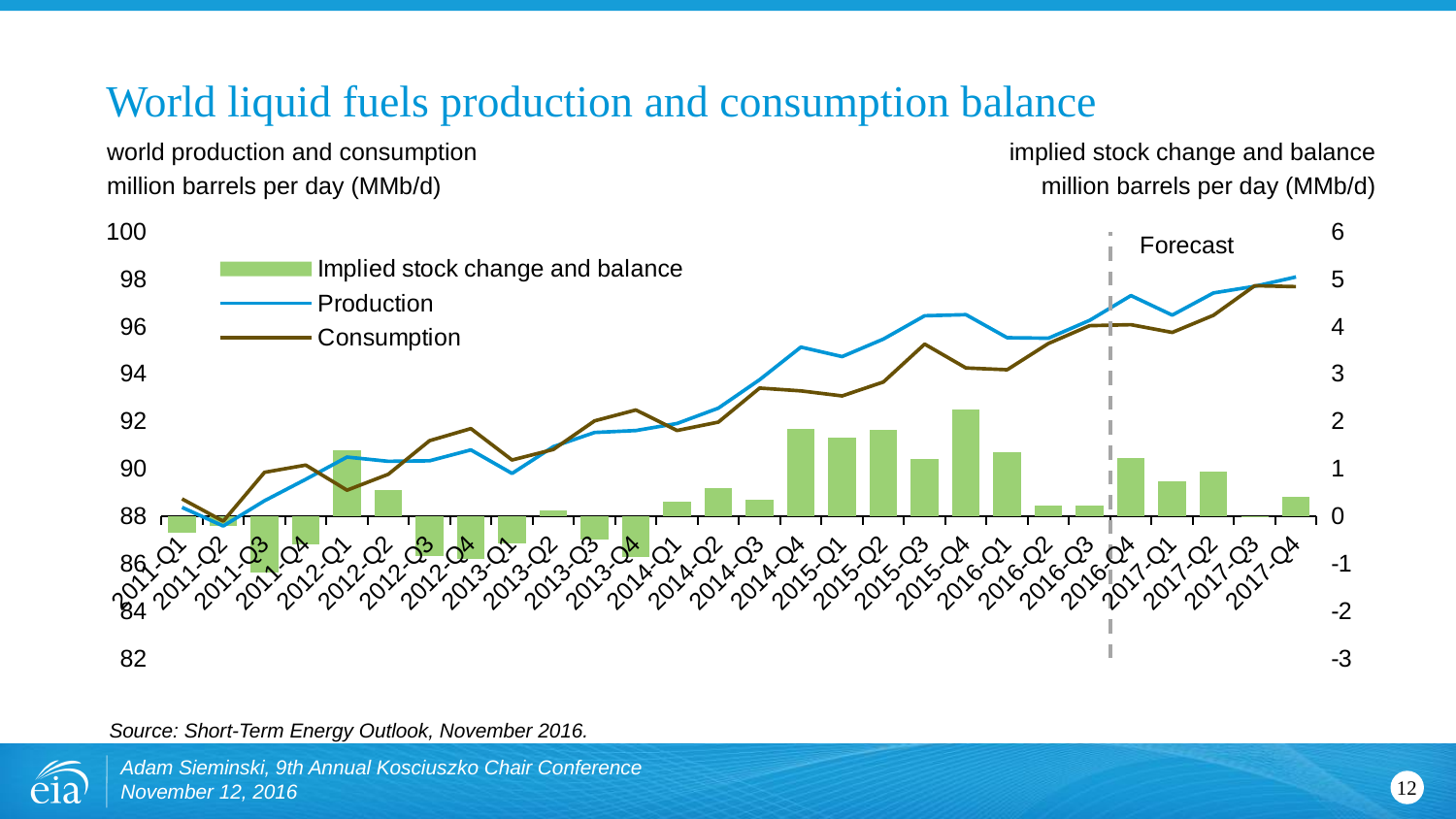
Is the consumption value for 2011-Q1 greater or less than 90 MMb/d? less Which quarter has the tallest implied stock change and balance bar? 2015-Q4 Is the implied stock change and balance for 2011-Q3 greater or less than 0? less Is the implied stock change and balance for 2015-Q4 greater or less than 1 MMb/d? greater Which quarter has the lowest (most negative) implied stock change and balance bar? 2011-Q3 How many quarters are shown along the x axis? 28 How many series does the legend list? 3 Does world production generally rise or fall from 2011-Q1 to 2017-Q4? Rise What label marks the period to the right of the dashed vertical line? Forecast In 2015-Q3, which is higher, production or consumption? Production What kind of chart is shown on the slide? A combination bar and line chart